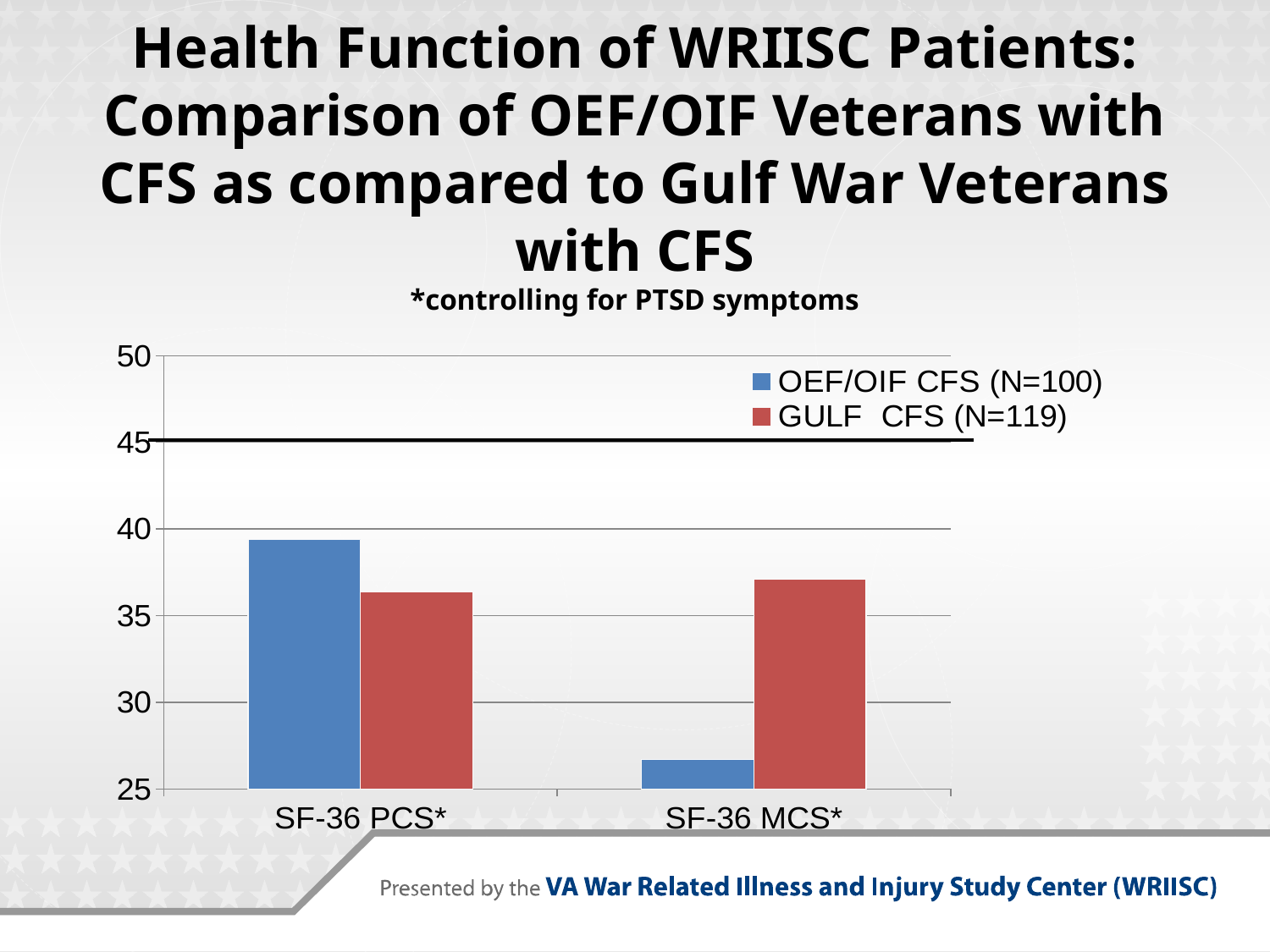
How many series does the legend list? 2 Is the GULF CFS value for SF-36 PCS* greater or less than 40? less Is the OEF/OIF CFS value for SF-36 PCS* greater or less than 35? greater Which series is shown in blue? OEF/OIF CFS (N=100) Which bar is the lowest in the chart? OEF/OIF CFS for SF-36 MCS* What kind of chart is shown on the slide? bar chart Is the OEF/OIF CFS value for SF-36 MCS* greater or less than 30? less For SF-36 MCS*, which series has the larger value, OEF/OIF CFS or GULF CFS? GULF CFS What sample size is given for the GULF CFS series in the legend? N=119 For SF-36 PCS*, which series has the larger value, OEF/OIF CFS or GULF CFS? OEF/OIF CFS How many categories are shown on the x axis? 2